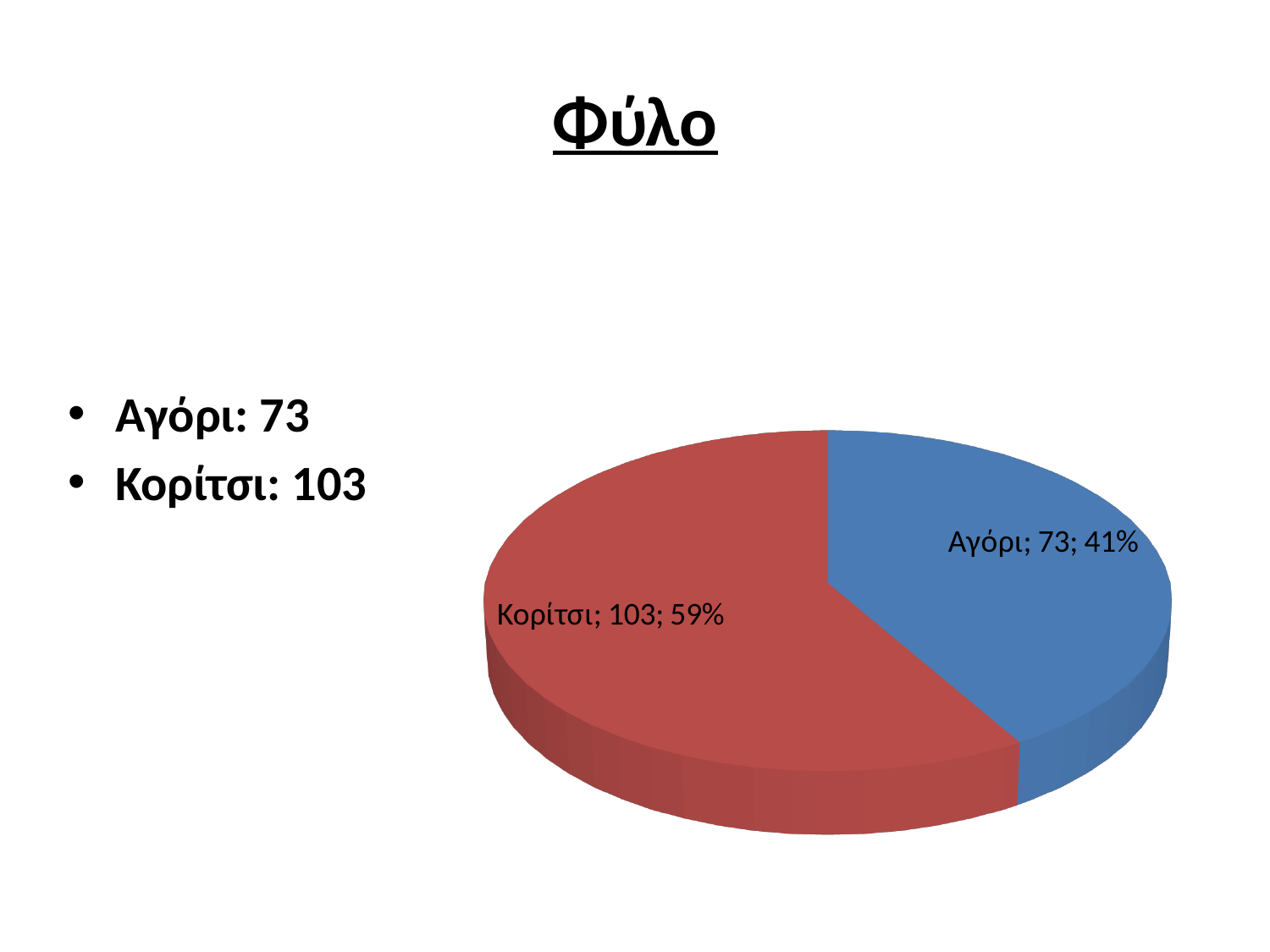
What share of the pie does Κορίτσι represent? 59% What is the difference between the values for Κορίτσι and Αγόρι? 30 What is the value for Κορίτσι in the pie chart? 103 Which category has the largest slice in the pie chart? Κορίτσι What colour is the Κορίτσι slice in the pie chart? red Which category has the smallest slice in the pie chart? Αγόρι What is the total of the two values shown in the pie chart? 176 Which is larger, the value for Αγόρι or the value for Κορίτσι? Κορίτσι How many slices does the pie chart have? 2 What is the value for Αγόρι in the pie chart? 73 What kind of chart is shown on the slide? pie chart What share of the pie does Αγόρι represent? 41%